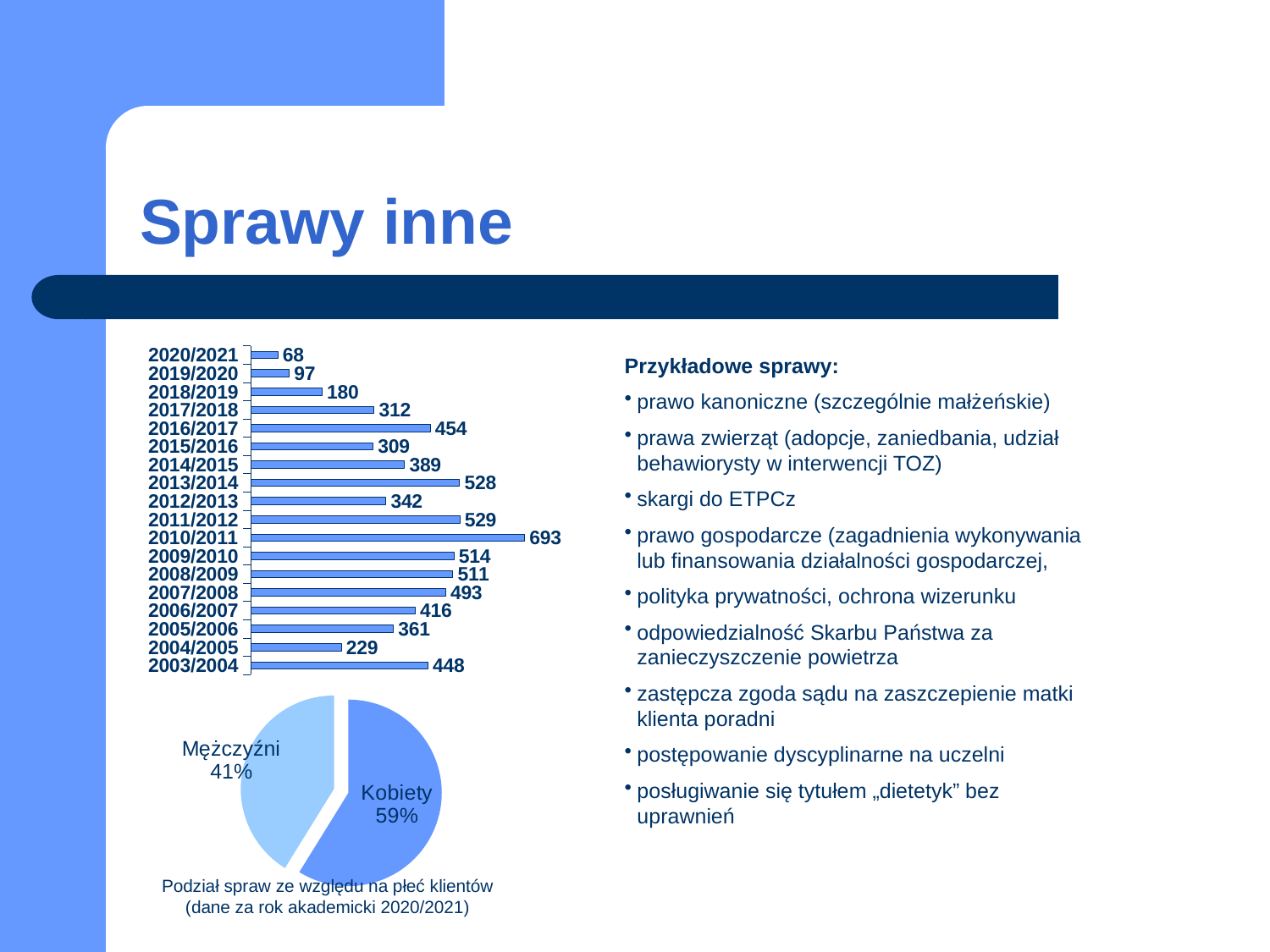
In the pie chart 'Podział spraw ze względu na płeć klientów', what share is Mężczyźni? 41% In the pie chart 'Podział spraw ze względu na płeć klientów', what share is Kobiety? 59% How many academic years are shown in the bar chart on the left? 18 What kind of chart is the upper chart on the left of the slide? Bar chart In the bar chart on the left, what is the value for 2016/2017? 454 In the bar chart on the left, which academic year has the lowest value? 2020/2021 In the bar chart on the left, which academic year has the highest value? 2010/2011 In the bar chart on the left, what is the value for 2003/2004? 448 In the bar chart on the left, what is the value for 2010/2011? 693 In the bar chart on the left, what is the difference between the values for 2013/2014 and 2012/2013? 186 In the bar chart on the left, do the values rise or fall from 2017/2018 to 2020/2021? Fall In the bar chart on the left, which is larger: the value for 2017/2018 or the value for 2015/2016? 2017/2018